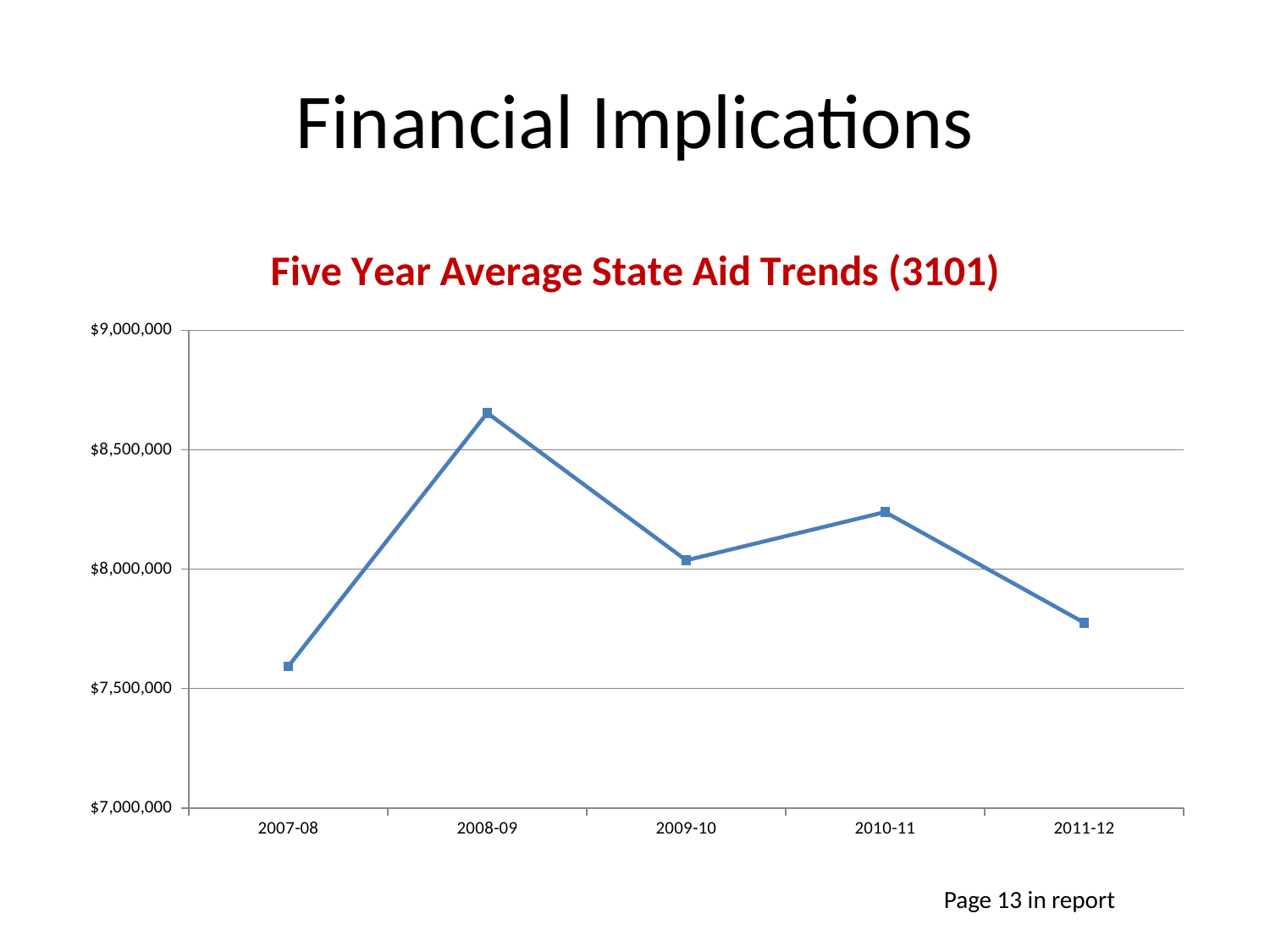
Is the value for 2010-11 greater or less than $8,500,000? less Does the value rise or fall from 2007-08 to 2008-09? rise Which year has the highest average state aid? 2008-09 Is the value for 2008-09 greater or less than $8,500,000? greater What is the title of the chart? Five Year Average State Aid Trends (3101) Which is larger, the value for 2009-10 or the value for 2010-11? 2010-11 Which year has the lowest average state aid? 2007-08 Is the value for 2011-12 greater or less than $8,000,000? less How many school years are plotted on the x axis? 5 Does the value rise or fall from 2010-11 to 2011-12? fall What kind of chart is shown on the slide? Line chart